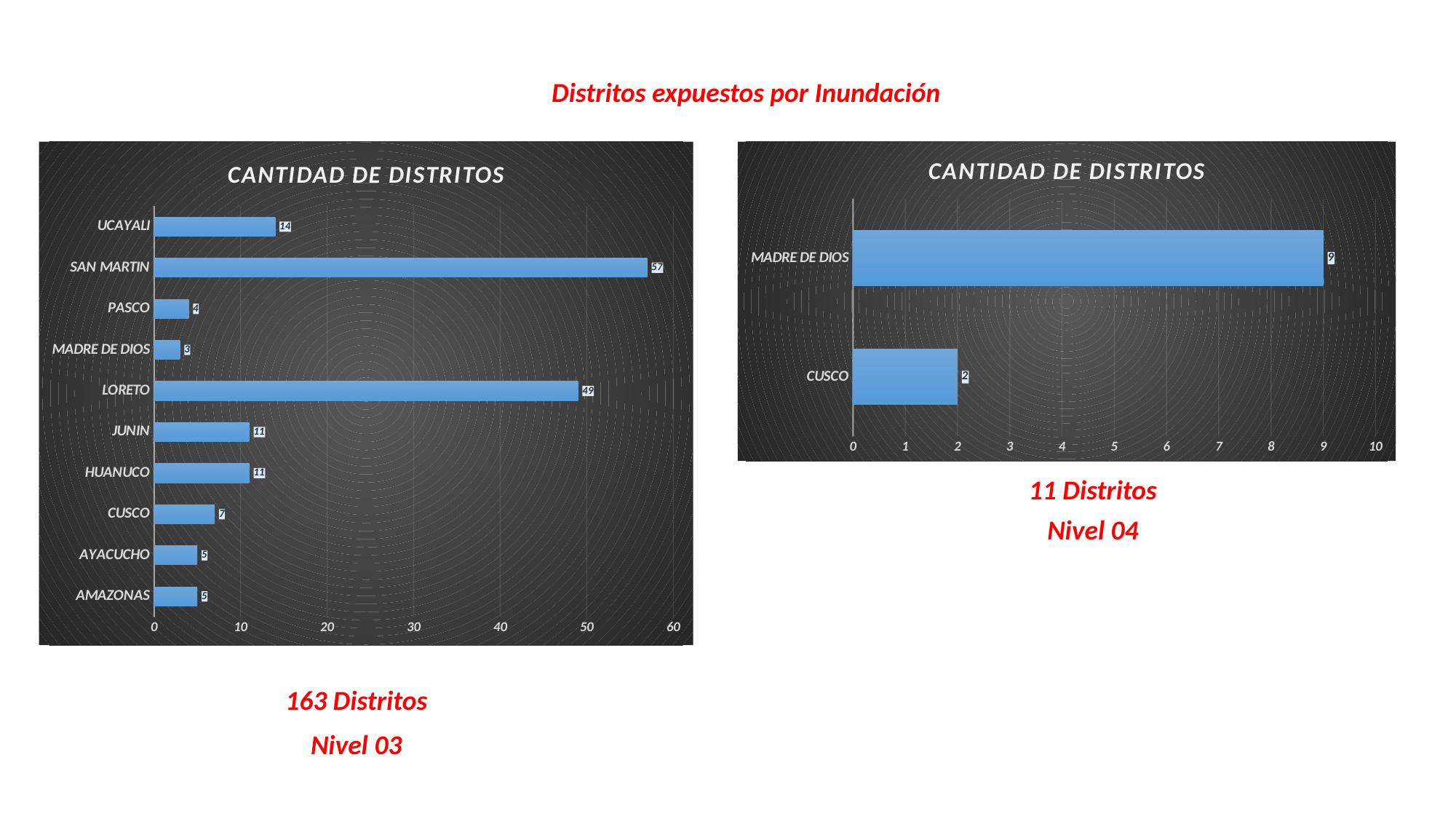
In the right chart (Nivel 04), what is the value for MADRE DE DIOS? 9 In the left chart (Nivel 03), what is the difference between SAN MARTIN and LORETO? 8 In the left chart (Nivel 03), which category has the highest value? SAN MARTIN In the right chart (Nivel 04), how many categories are shown? 2 In the right chart (Nivel 04), what is the difference between MADRE DE DIOS and CUSCO? 7 In the left chart (Nivel 03), what is the value for LORETO? 49 In the left chart (Nivel 03), what is the value for SAN MARTIN? 57 In the left chart (Nivel 03), which category has the lowest value? MADRE DE DIOS What type of chart is the right chart (Nivel 04)? Bar chart In the left chart (Nivel 03), how many categories are shown? 10 In the left chart (Nivel 03), which is larger, UCAYALI or CUSCO? UCAYALI In the left chart (Nivel 03), is the value for LORETO greater or less than 40? greater